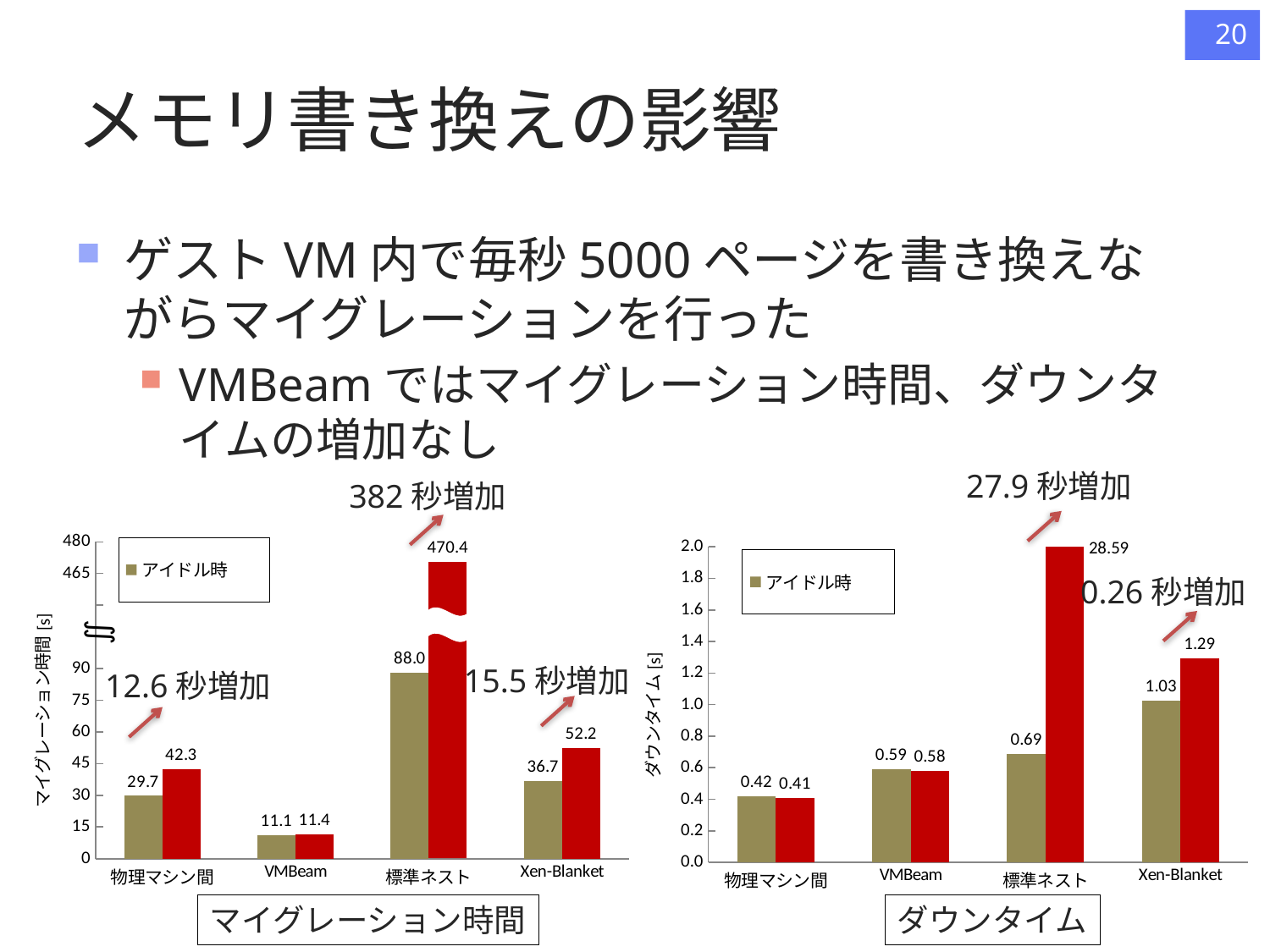
In the ダウンタイム chart, what value is labelled on the red bar for 標準ネスト? 28.59 How many categories are shown on the x axis of the マイグレーション時間 chart? 4 In the マイグレーション時間 chart, what is the アイドル時 value for 標準ネスト? 88.0 In the ダウンタイム chart, what is the difference between the red bar and the アイドル時 bar for Xen-Blanket? 0.26 In the マイグレーション時間 chart, what value is labelled on the red bar for Xen-Blanket? 52.2 In the ダウンタイム chart, what is the アイドル時 value for Xen-Blanket? 1.03 In the ダウンタイム chart, which category has the highest red-bar value? 標準ネスト What kind of chart is the ダウンタイム chart? Bar chart In the ダウンタイム chart, which is larger for 物理マシン間: the アイドル時 bar or the red bar? アイドル時 What is the y-axis label of the ダウンタイム chart? ダウンタイム [s] In the マイグレーション時間 chart, which category has the lowest アイドル時 value? VMBeam In the マイグレーション時間 chart, what is the difference between the red bar and the アイドル時 bar for 物理マシン間? 12.6